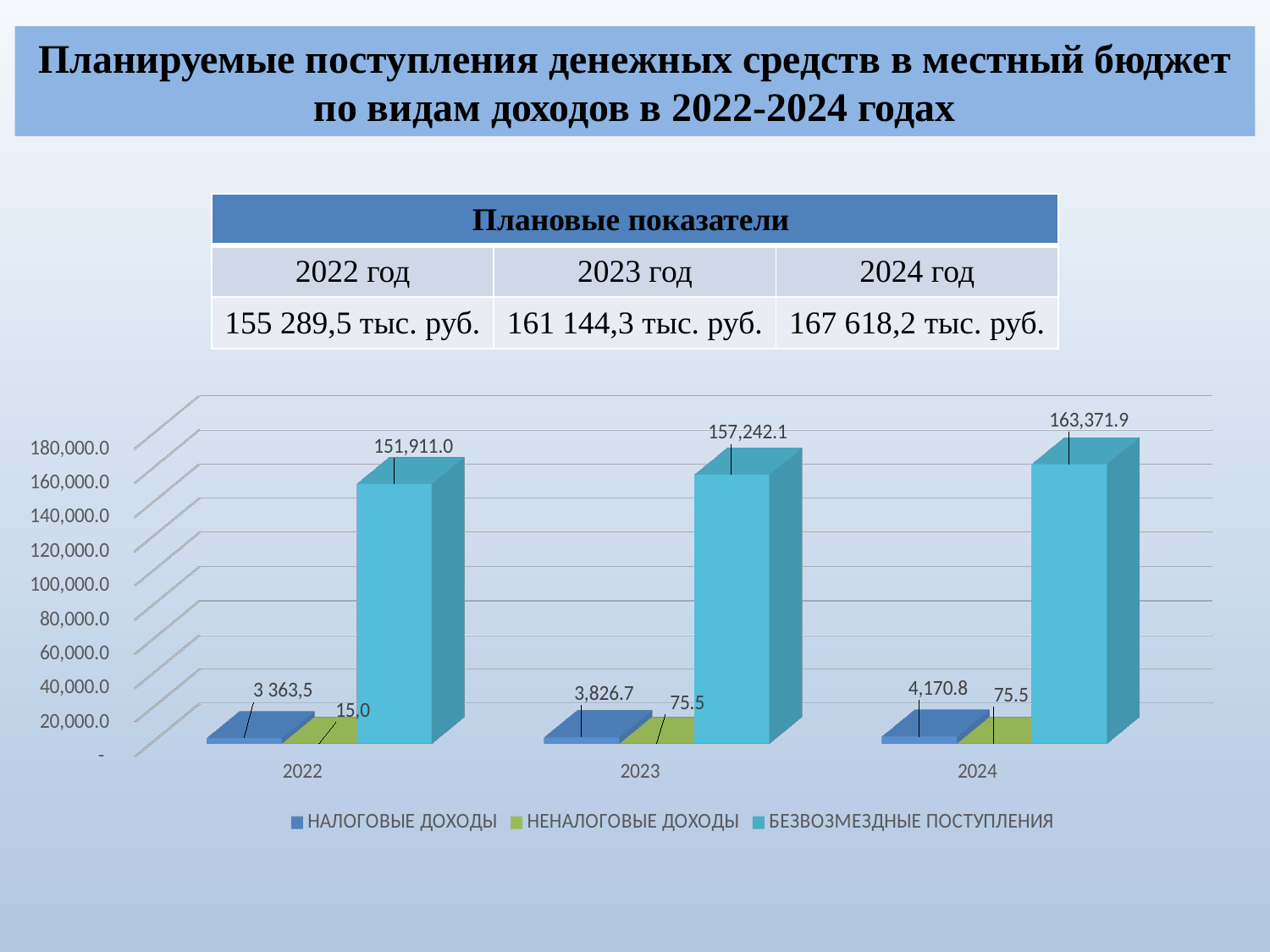
What is the difference between БЕЗВОЗМЕЗДНЫЕ ПОСТУПЛЕНИЯ in 2024 and in 2023? 6,129.8 In which year is БЕЗВОЗМЕЗДНЫЕ ПОСТУПЛЕНИЯ highest? 2024 In which year is НЕНАЛОГОВЫЕ ДОХОДЫ lowest? 2022 What is the value of НАЛОГОВЫЕ ДОХОДЫ for 2024? 4,170.8 Which is larger: НАЛОГОВЫЕ ДОХОДЫ in 2023 or in 2024? 2024 Do the values of БЕЗВОЗМЕЗДНЫЕ ПОСТУПЛЕНИЯ rise or fall from 2022 to 2024? rise How many years (categories) are shown on the x axis of the chart? 3 How many series does the chart legend list? 3 What is the value of НЕНАЛОГОВЫЕ ДОХОДЫ for 2023? 75.5 Is the value of БЕЗВОЗМЕЗДНЫЕ ПОСТУПЛЕНИЯ for 2022 greater or less than 140,000.0? greater What type of chart is shown on the slide? bar chart What is the value of БЕЗВОЗМЕЗДНЫЕ ПОСТУПЛЕНИЯ for 2022? 151,911.0